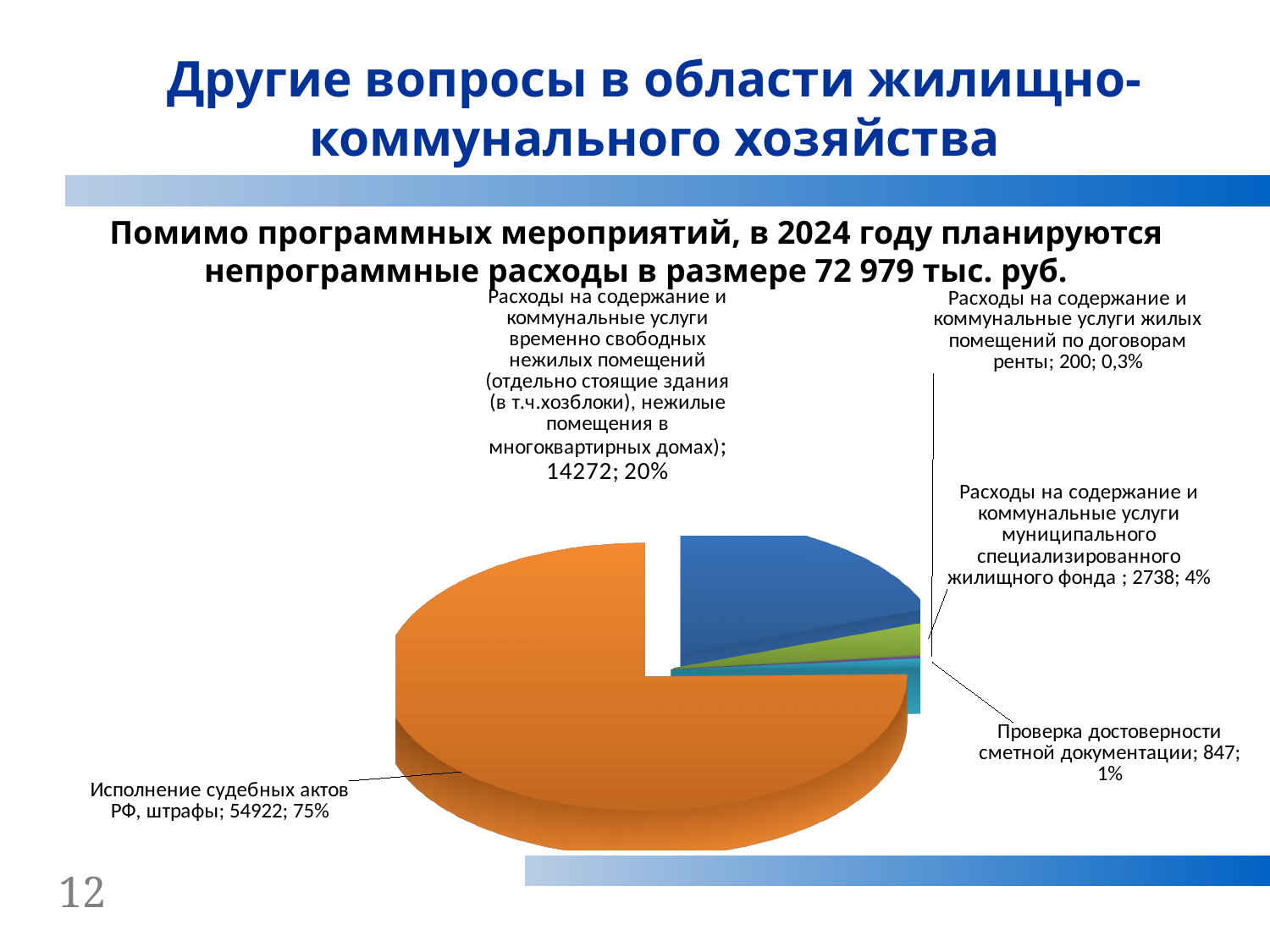
What is the value for "Исполнение судебных актов РФ, штрафы"? 54922 Which category has the largest slice of the pie? Исполнение судебных актов РФ, штрафы What is the difference between the value for "Исполнение судебных актов РФ, штрафы" and the value for the temporarily vacant non-residential premises category ("Расходы на содержание и коммунальные услуги временно свободных нежилых помещений")? 40650 What is the value for "Проверка достоверности сметной документации"? 847 What kind of chart is shown on the slide? pie chart What is the value for "Расходы на содержание и коммунальные услуги муниципального специализированного жилищного фонда"? 2738 Which is larger: the value for "Проверка достоверности сметной документации" or the value for "Расходы на содержание и коммунальные услуги муниципального специализированного жилищного фонда"? Расходы на содержание и коммунальные услуги муниципального специализированного жилищного фонда What is the total of all the values shown in the pie chart? 72979 How many slices does the pie chart have? 5 What share of the pie does "Исполнение судебных актов РФ, штрафы" represent? 75% Which category has the smallest slice of the pie? Расходы на содержание и коммунальные услуги жилых помещений по договорам ренты What share of the pie does "Расходы на содержание и коммунальные услуги жилых помещений по договорам ренты" represent? 0,3%